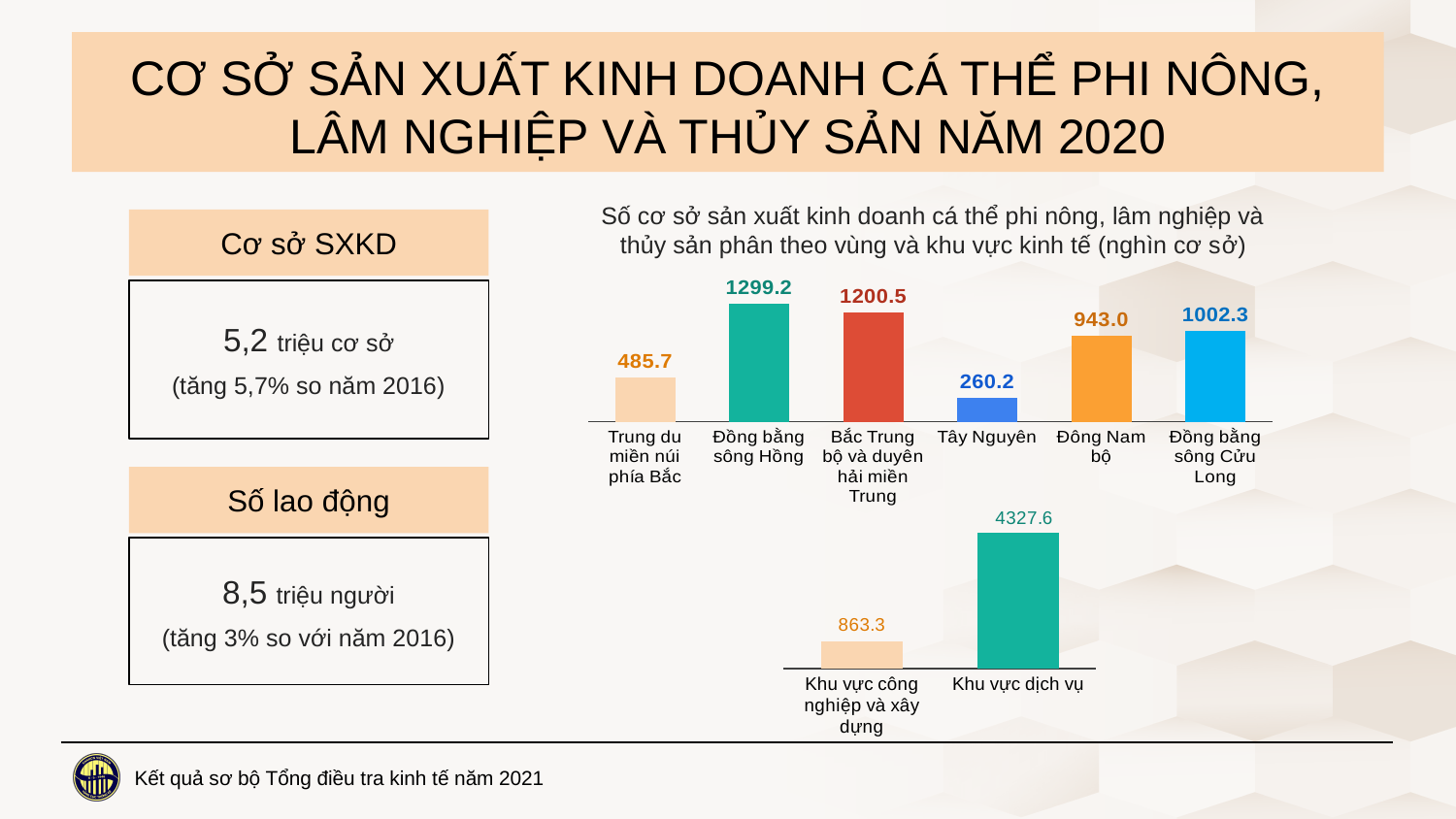
What unit is stated in the title of the upper chart? nghìn cơ sở In the upper chart (by region), what is the value for Đồng bằng sông Cửu Long? 1002.3 In the lower chart (by economic sector), what is the difference between Khu vực dịch vụ and Khu vực công nghiệp và xây dựng? 3464.3 In the upper chart (by region), which region has the highest value? Đồng bằng sông Hồng How many regions are shown in the upper chart? 6 In the lower chart (by economic sector), what is the value for Khu vực công nghiệp và xây dựng? 863.3 In the upper chart (by region), what is the difference between Đồng bằng sông Hồng and Bắc Trung bộ và duyên hải miền Trung? 98.7 In the upper chart (by region), what is the value for Tây Nguyên? 260.2 What type of chart is the upper chart (by region)? Bar chart In the lower chart (by economic sector), what is the value for Khu vực dịch vụ? 4327.6 In the upper chart (by region), which region has the lowest value? Tây Nguyên In the upper chart (by region), which is larger: Đông Nam bộ or Đồng bằng sông Cửu Long? Đồng bằng sông Cửu Long